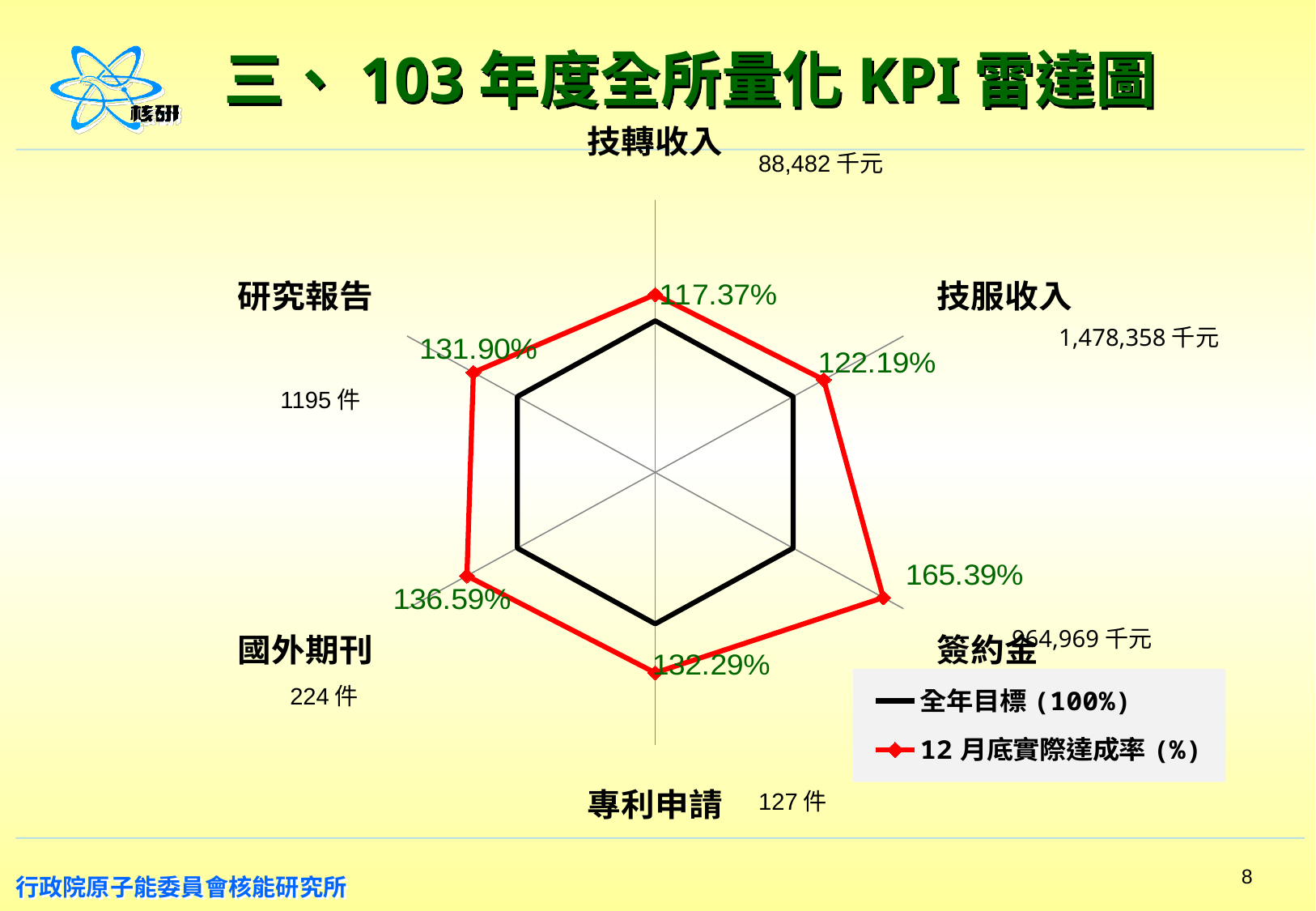
Which category has the lowest 12 月底實際達成率? 技轉收入 How many series does the legend list? 2 What kind of chart is shown on the slide? Radar chart What is the 12 月底實際達成率 value for 研究報告? 131.90% What is the 12 月底實際達成率 value for 技轉收入? 117.37% Which category has the highest 12 月底實際達成率? 簽約金 What colour is the line for 12 月底實際達成率 (%)? Red Which has a higher 12 月底實際達成率, 技服收入 or 專利申請? 專利申請 What is the difference between the 12 月底實際達成率 for 簽約金 and 技轉收入? 48.02% What is the 12 月底實際達成率 value for 簽約金? 165.39% How many categories does the radar chart have? 6 What is the 12 月底實際達成率 value for 國外期刊? 136.59%